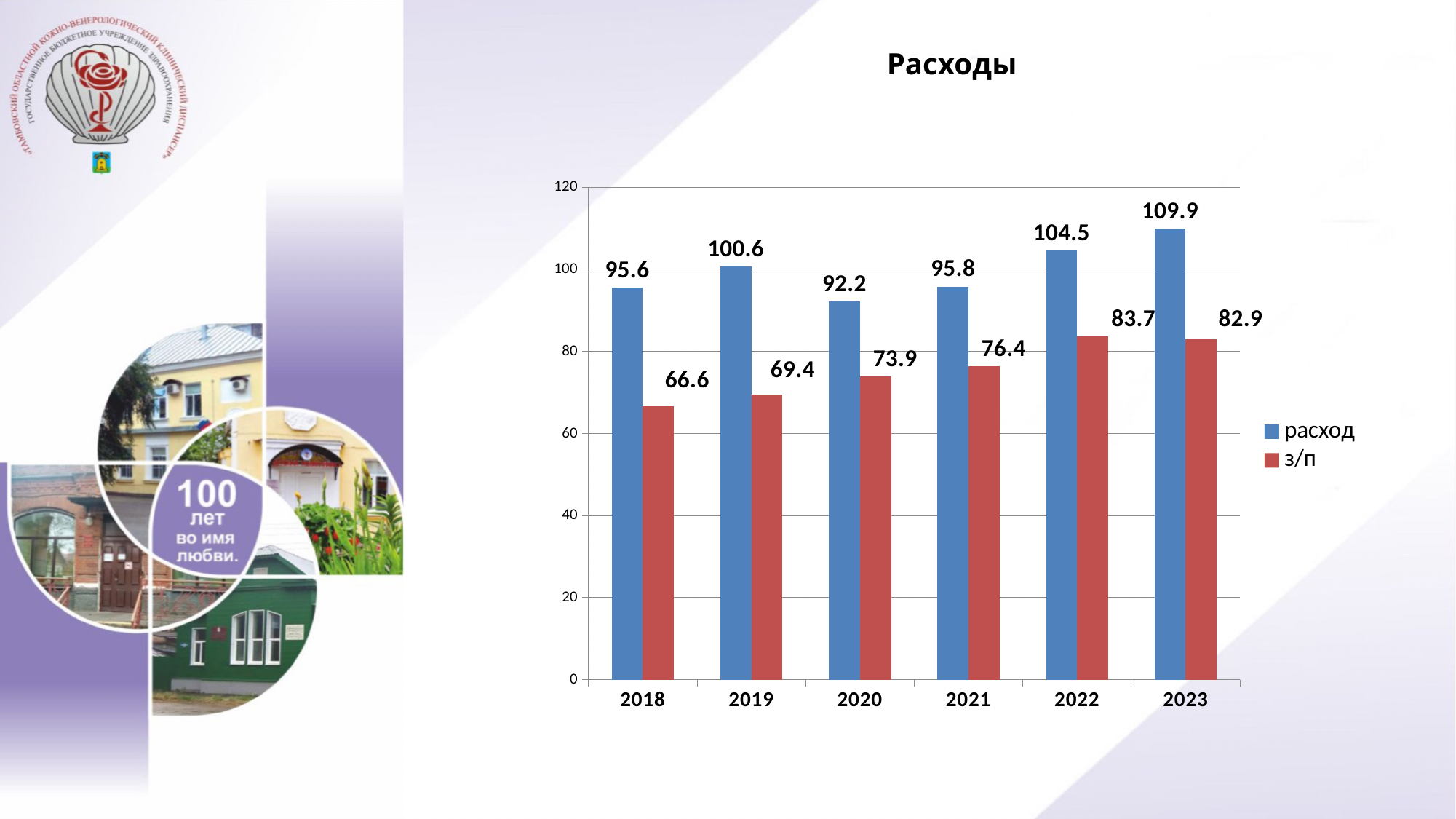
What is the title of the chart? Расходы How many years are shown on the x axis? 6 Which year has the highest расход value? 2023 What kind of chart is shown on the slide? bar chart Does the з/п series rise or fall from 2018 to 2023? rise What is the value of расход for 2019? 100.6 Which year has the lowest з/п value? 2018 Is the з/п value for 2022 greater or less than 80? greater What is the value of з/п for 2021? 76.4 How many series does the legend list? 2 Which is larger: расход in 2020 or расход in 2021? расход in 2021 What is the difference between расход and з/п in 2023? 27.0